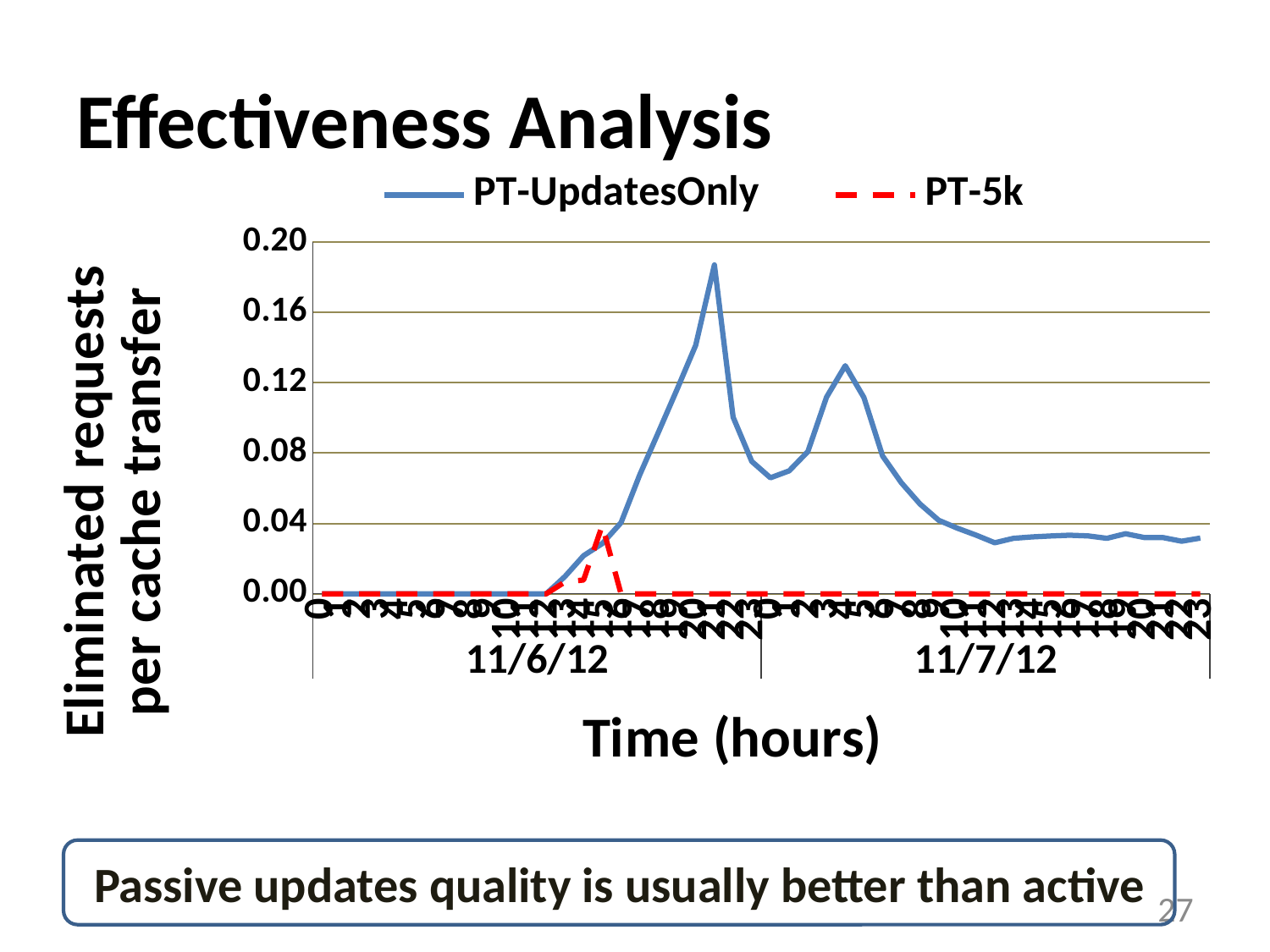
Is the value of PT-UpdatesOnly at the start of 11/6/12 greater or less than 0.04? less Which series reaches the highest value on the chart? PT-UpdatesOnly Does the PT-UpdatesOnly line rise or fall immediately after its highest peak? fall Which series has the larger peak, PT-UpdatesOnly or PT-5k? PT-UpdatesOnly Is the value of PT-UpdatesOnly at the far right end of the chart greater or less than 0.04? less Is the peak value of PT-UpdatesOnly greater or less than 0.16? greater Which series is drawn as a red dashed line? PT-5k What kind of chart is shown on the slide? line chart What is the title of the y axis? Eliminated requests per cache transfer How many series does the legend list? 2